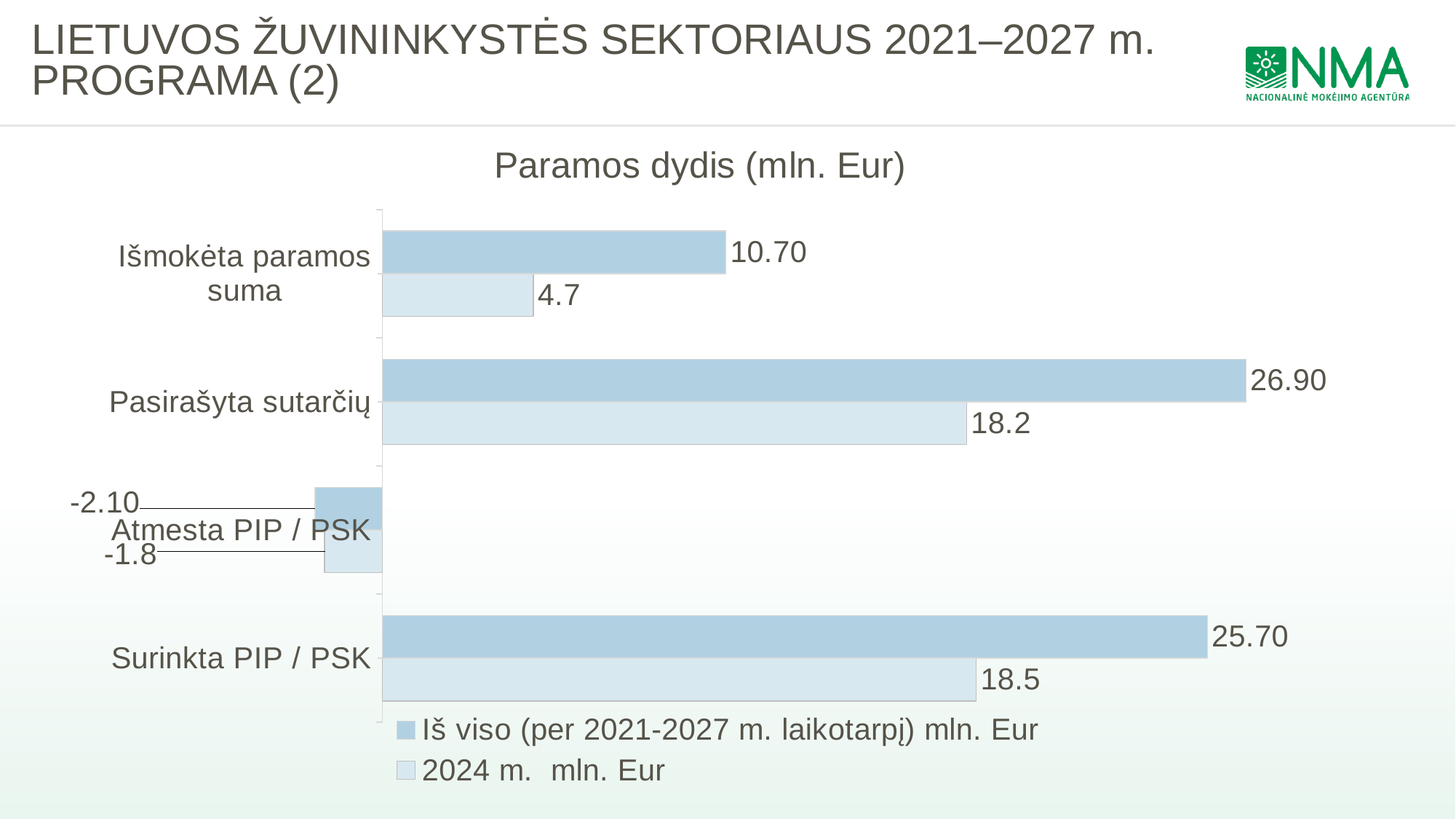
What is the value for Atmesta PIP / PSK in the series 'Iš viso (per 2021-2027 m. laikotarpį) mln. Eur'? -2.10 Which category has the highest value in the series 'Iš viso (per 2021-2027 m. laikotarpį) mln. Eur'? Pasirašyta sutarčių What is the title of the chart? Paramos dydis (mln. Eur) In the series '2024 m. mln. Eur', which is larger: Pasirašyta sutarčių or Išmokėta paramos suma? Pasirašyta sutarčių What is the value for Surinkta PIP / PSK in the series '2024 m. mln. Eur'? 18.5 How many series does the legend list? 2 What is the value for Išmokėta paramos suma in the series '2024 m. mln. Eur'? 4.7 What is the difference between the 'Iš viso' value and the '2024 m.' value for Surinkta PIP / PSK? 7.2 Which category has the lowest value in the series '2024 m. mln. Eur'? Atmesta PIP / PSK How many categories are shown on the chart? 4 What kind of chart is shown on the slide? bar chart What is the value for Pasirašyta sutarčių in the series 'Iš viso (per 2021-2027 m. laikotarpį) mln. Eur'? 26.90